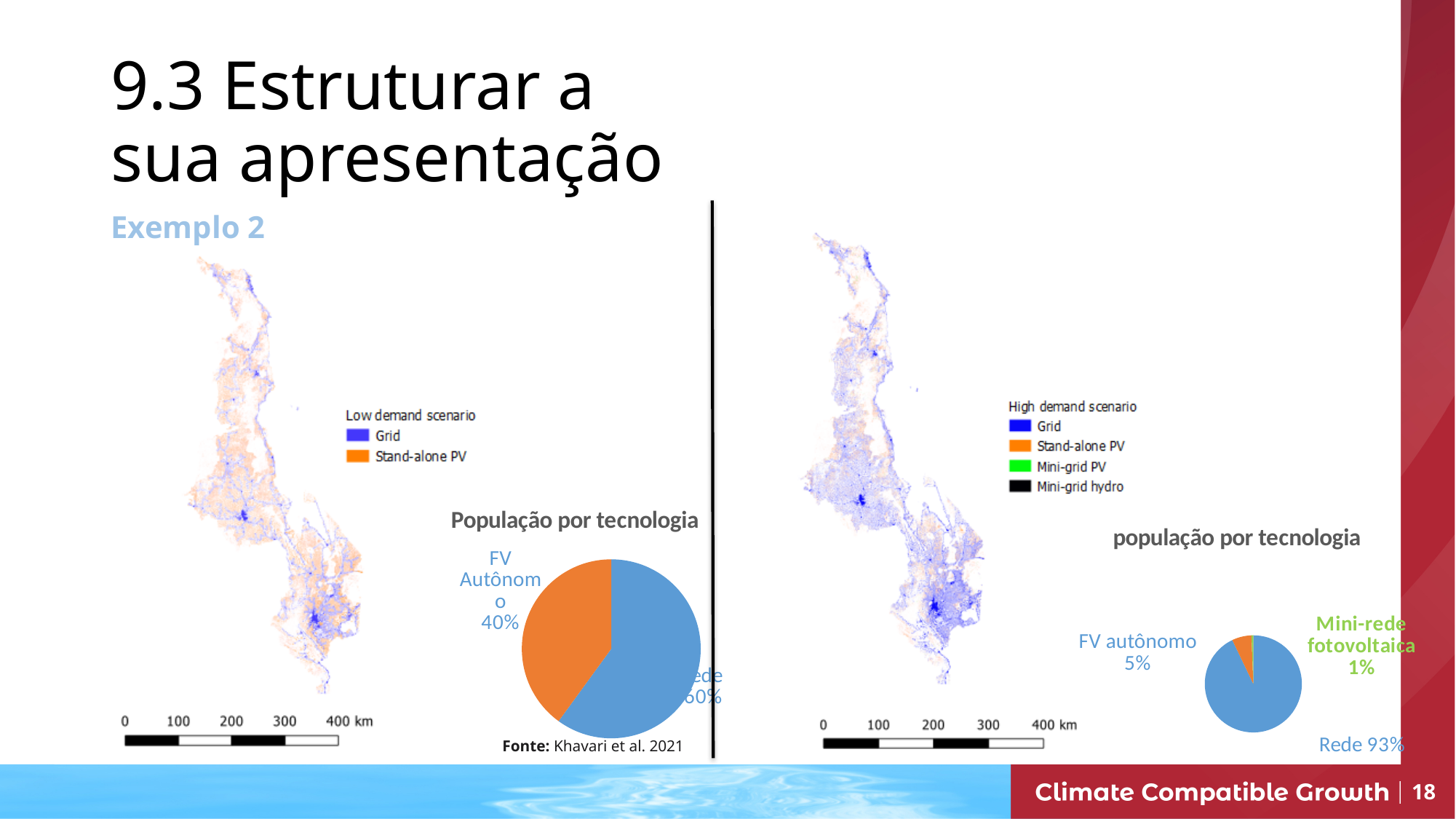
What kind of chart is the 'População por tecnologia' chart on the left side of the slide? Pie chart In the left pie chart 'População por tecnologia', what share is labelled for Rede? 60% In the left pie chart 'População por tecnologia', what share is labelled for FV Autônomo? 40% In the right pie chart 'população por tecnologia', which labelled category has the largest share? Rede In the right pie chart 'população por tecnologia', what share is labelled for Rede? 93% In the right pie chart 'população por tecnologia', what share is labelled for Mini-rede fotovoltaica? 1% In the right pie chart 'população por tecnologia', which is larger, FV autônomo or Mini-rede fotovoltaica? FV autônomo In the left pie chart 'População por tecnologia', what is the difference in percentage points between Rede and FV Autônomo? 20 percentage points What source is cited below the left pie chart? Khavari et al. 2021 In the left pie chart 'População por tecnologia', which slice is larger, Rede or FV Autônomo? Rede In the right pie chart 'população por tecnologia', what share is labelled for FV autônomo? 5% In the left pie chart 'População por tecnologia', how many slices does the pie have? 2